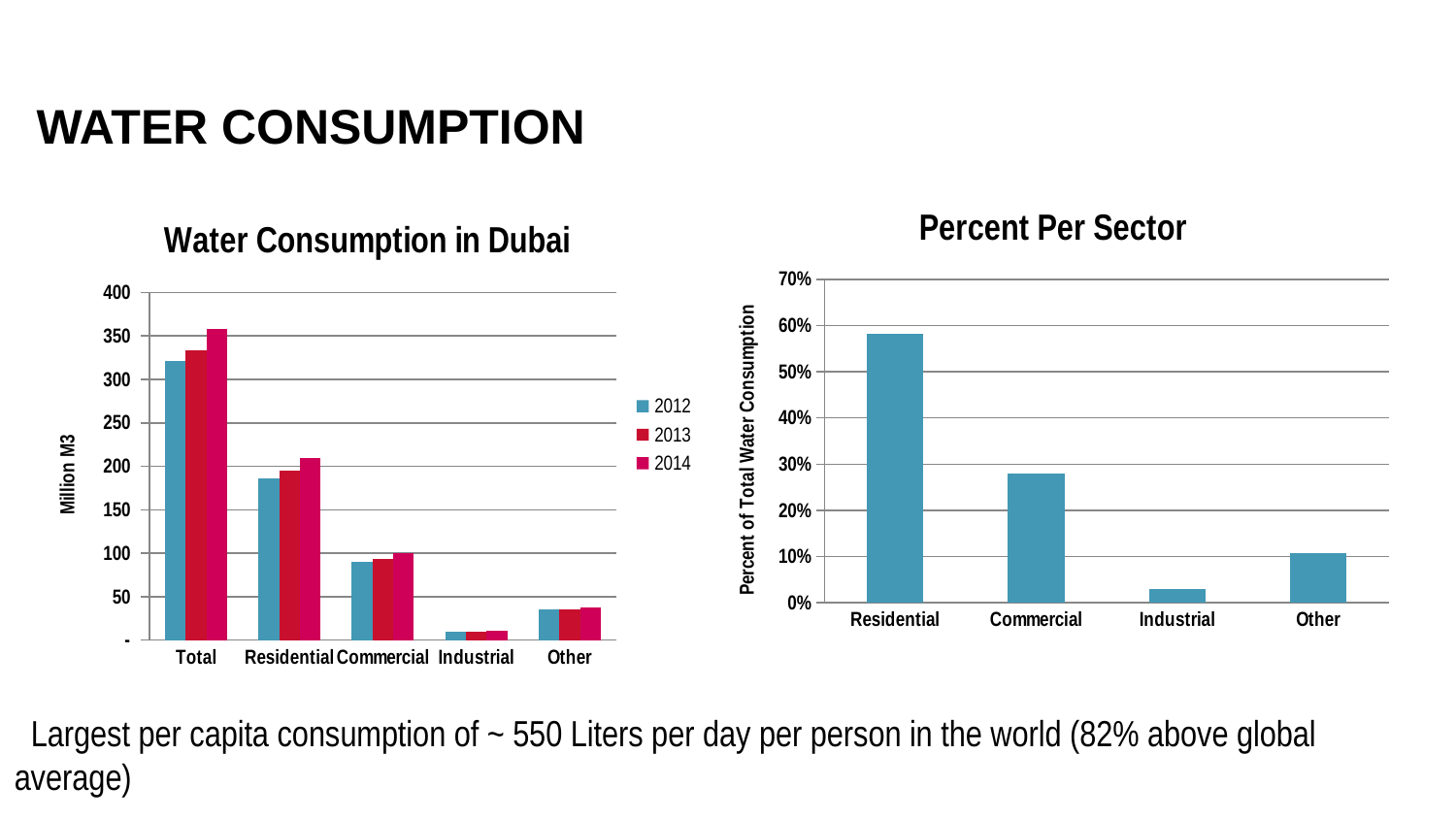
In the "Percent Per Sector" chart, is the value for Commercial greater or less than 30%? less In the "Water Consumption in Dubai" chart, which category has the lowest bars? Industrial In the "Water Consumption in Dubai" chart, is the 2012 value for Commercial greater or less than 100? less How many series does the legend of the "Water Consumption in Dubai" chart list? 3 In the "Percent Per Sector" chart, which sector has the highest value? Residential What is the y-axis label of the "Water Consumption in Dubai" chart? Million M3 What kind of chart is the "Water Consumption in Dubai" chart? bar chart In the "Water Consumption in Dubai" chart, is the 2014 value for Residential greater or less than 200? greater How many categories are shown on the x axis of the "Water Consumption in Dubai" chart? 5 In the "Water Consumption in Dubai" chart, do the values for Total rise or fall from 2012 to 2014? rise